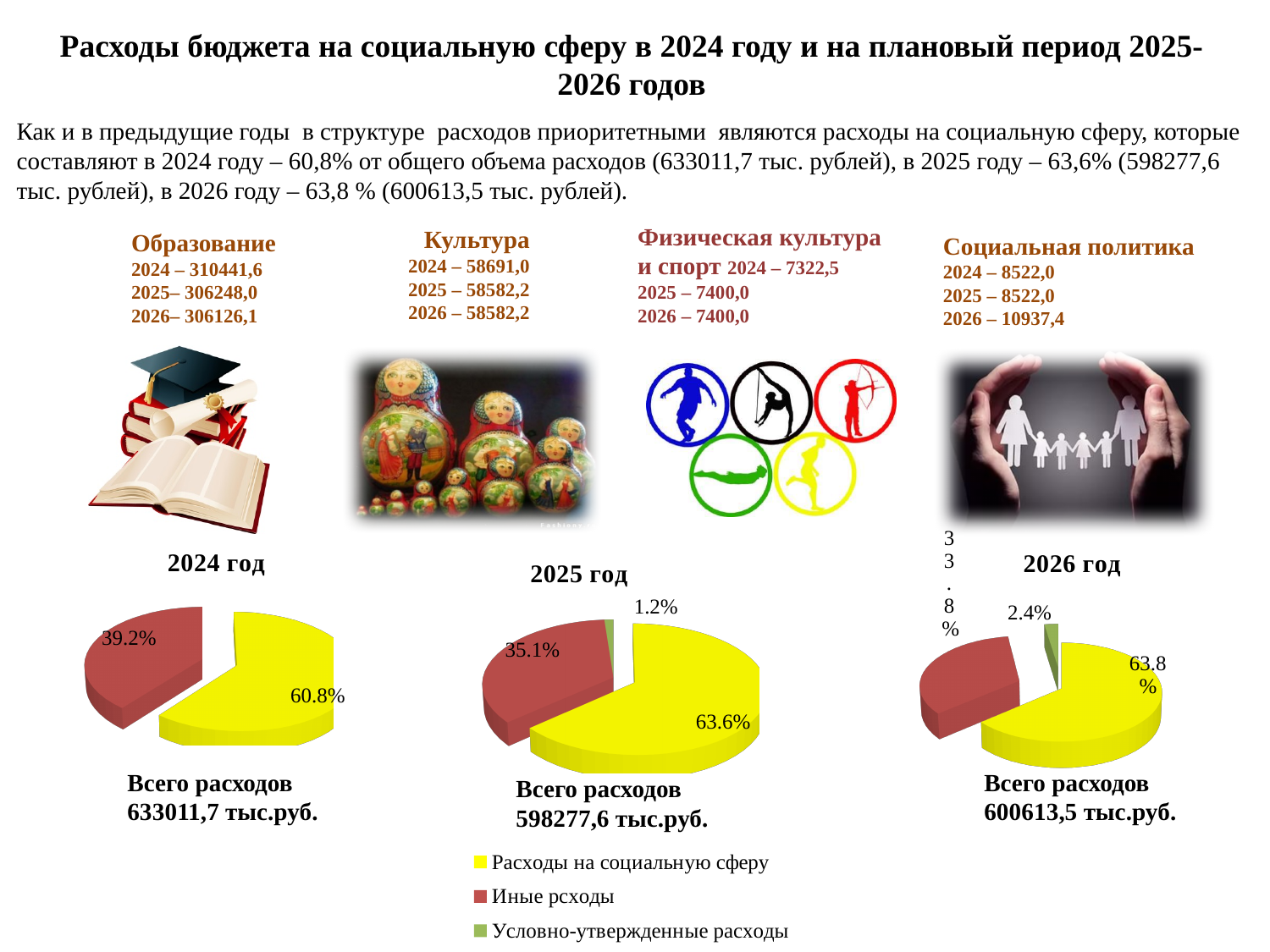
What type of chart is used for "2024 год", "2025 год" and "2026 год"? Pie chart Which is larger: the share for Расходы на социальную сферу in the "2024 год" chart or in the "2026 год" chart? 2026 год In the "2025 год" pie chart, what share is shown for Условно-утвержденные расходы (green slice)? 1.2% In the "2026 год" pie chart, what share is shown for Условно-утвержденные расходы? 2.4% In the "2024 год" pie chart, what share is shown for Расходы на социальную сферу (yellow slice)? 60.8% In the "2026 год" pie chart, which slice is the smallest? Условно-утвержденные расходы In the "2025 год" pie chart, which slice is the largest? Расходы на социальную сферу How many series does the shared legend below the pie charts list? 3